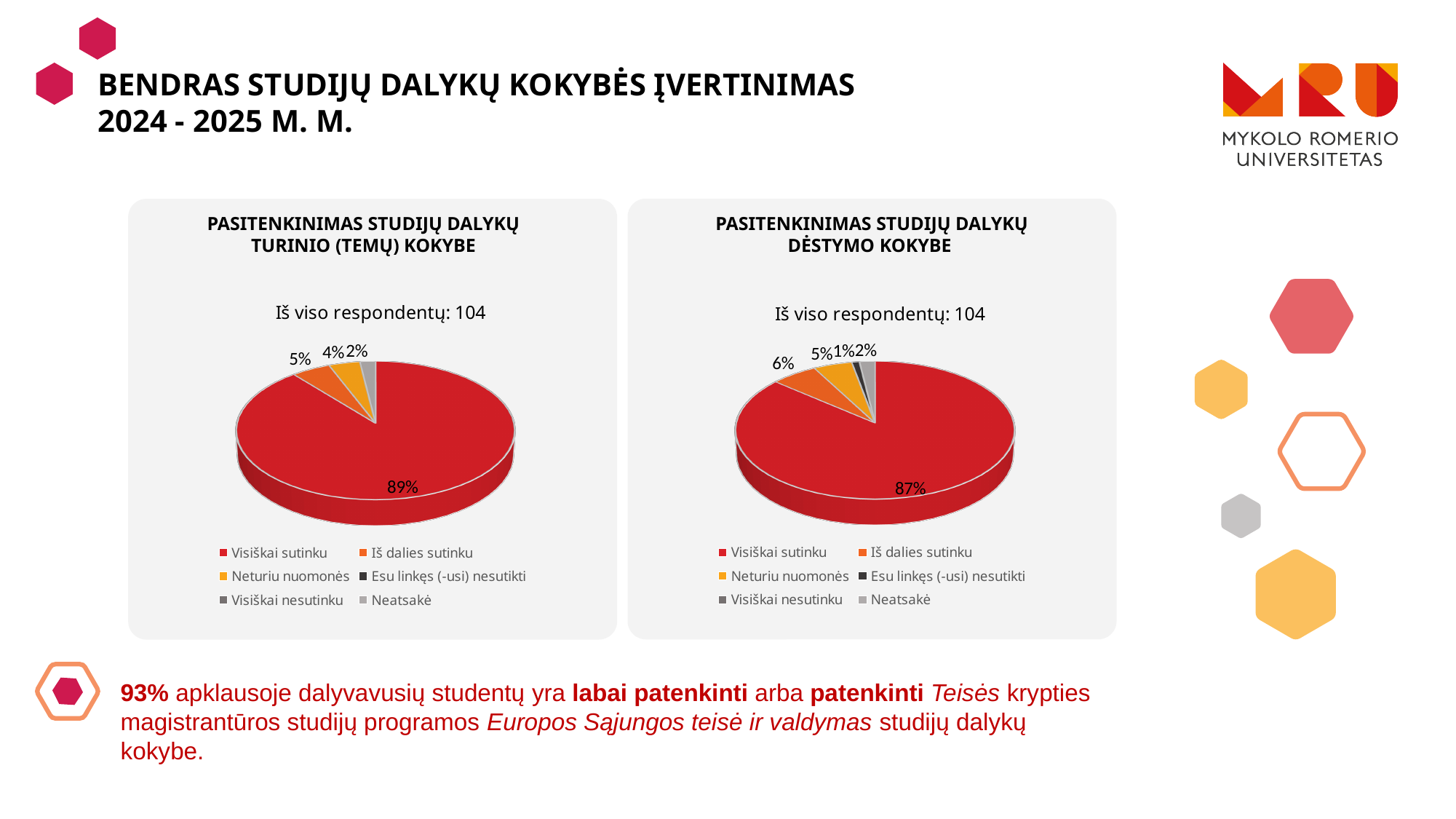
How many entries does the legend of the left chart (Pasitenkinimas studijų dalykų turinio (temų) kokybe) list? 6 What is the difference between the "Visiškai sutinku" share in the left chart and the "Visiškai sutinku" share in the right chart? 2 percentage points In the right chart (Pasitenkinimas studijų dalykų dėstymo kokybe), what percentage is shown for "Esu linkęs (-usi) nesutikti"? 1% How many respondents in total are reported for the right chart (Pasitenkinimas studijų dalykų dėstymo kokybe)? 104 In the right chart (Pasitenkinimas studijų dalykų dėstymo kokybe), what share of respondents answered "Visiškai sutinku"? 87% In the left chart (Pasitenkinimas studijų dalykų turinio (temų) kokybe), which category has the largest slice? Visiškai sutinku Which chart has the larger "Visiškai sutinku" share, the left one (turinio kokybe) or the right one (dėstymo kokybe)? The left one (turinio kokybe) In the right chart (Pasitenkinimas studijų dalykų dėstymo kokybe), which category has the smallest labelled slice? Esu linkęs (-usi) nesutikti What type of chart is used on this slide? Pie chart In the left chart (Pasitenkinimas studijų dalykų turinio (temų) kokybe), what share of respondents answered "Visiškai sutinku"? 89% In the right chart (Pasitenkinimas studijų dalykų dėstymo kokybe), what percentage is shown for "Iš dalies sutinku"? 6% In the left chart (Pasitenkinimas studijų dalykų turinio (temų) kokybe), what percentage is shown for "Iš dalies sutinku"? 5%